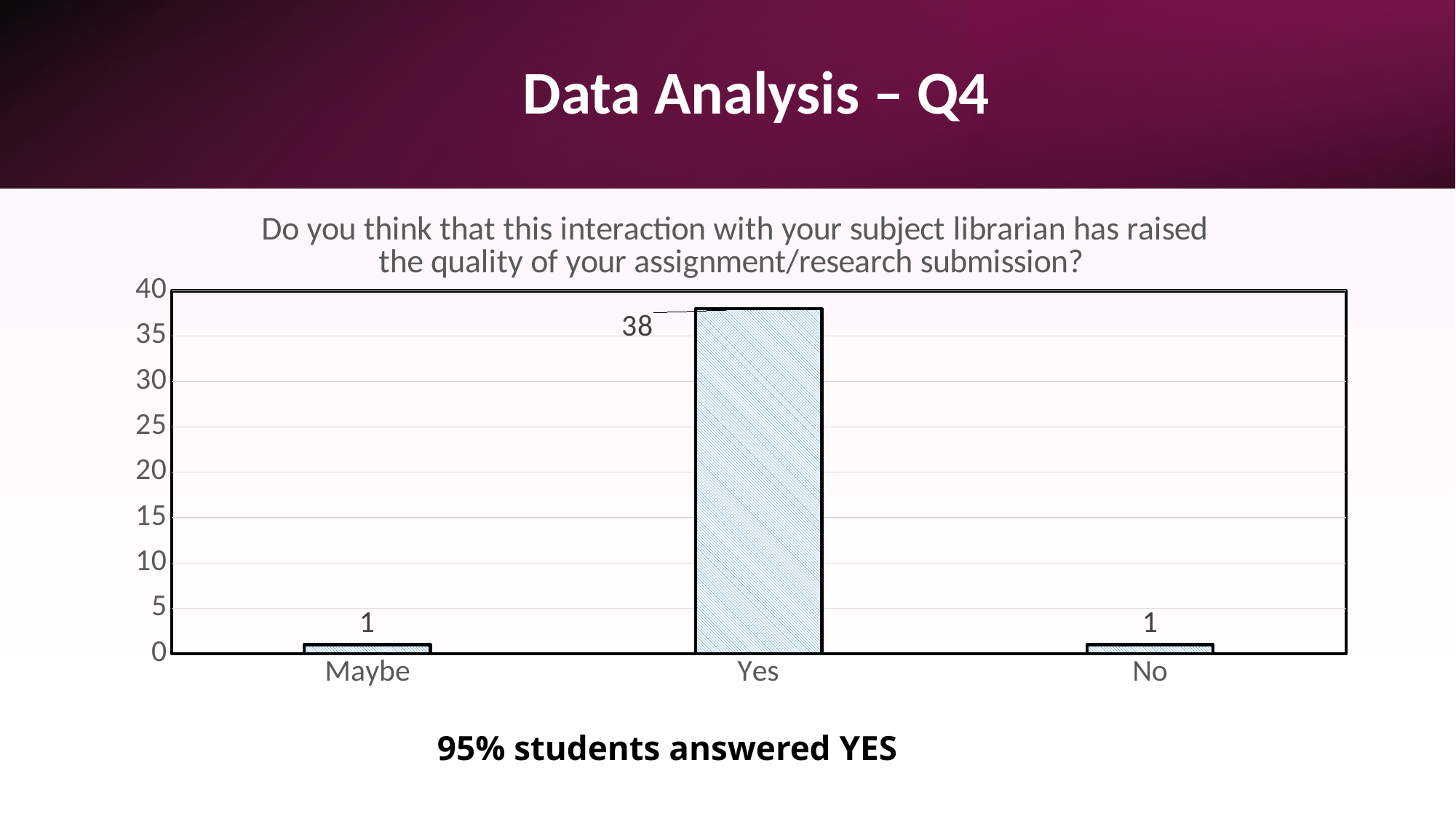
What is the value for Maybe? 1 Is the value for Yes greater or less than 35? greater How many categories are shown on the x axis? 3 What is the value for No? 1 What kind of chart is shown? bar chart Which category has the highest value? Yes What is the difference between the values for Yes and No? 37 What is the value for Yes? 38 Is the value for Maybe greater or less than 5? less What is the total of the values for Maybe, Yes and No? 40 Which is larger, the value for Yes or the value for Maybe? Yes What is the highest value shown on the y axis? 40